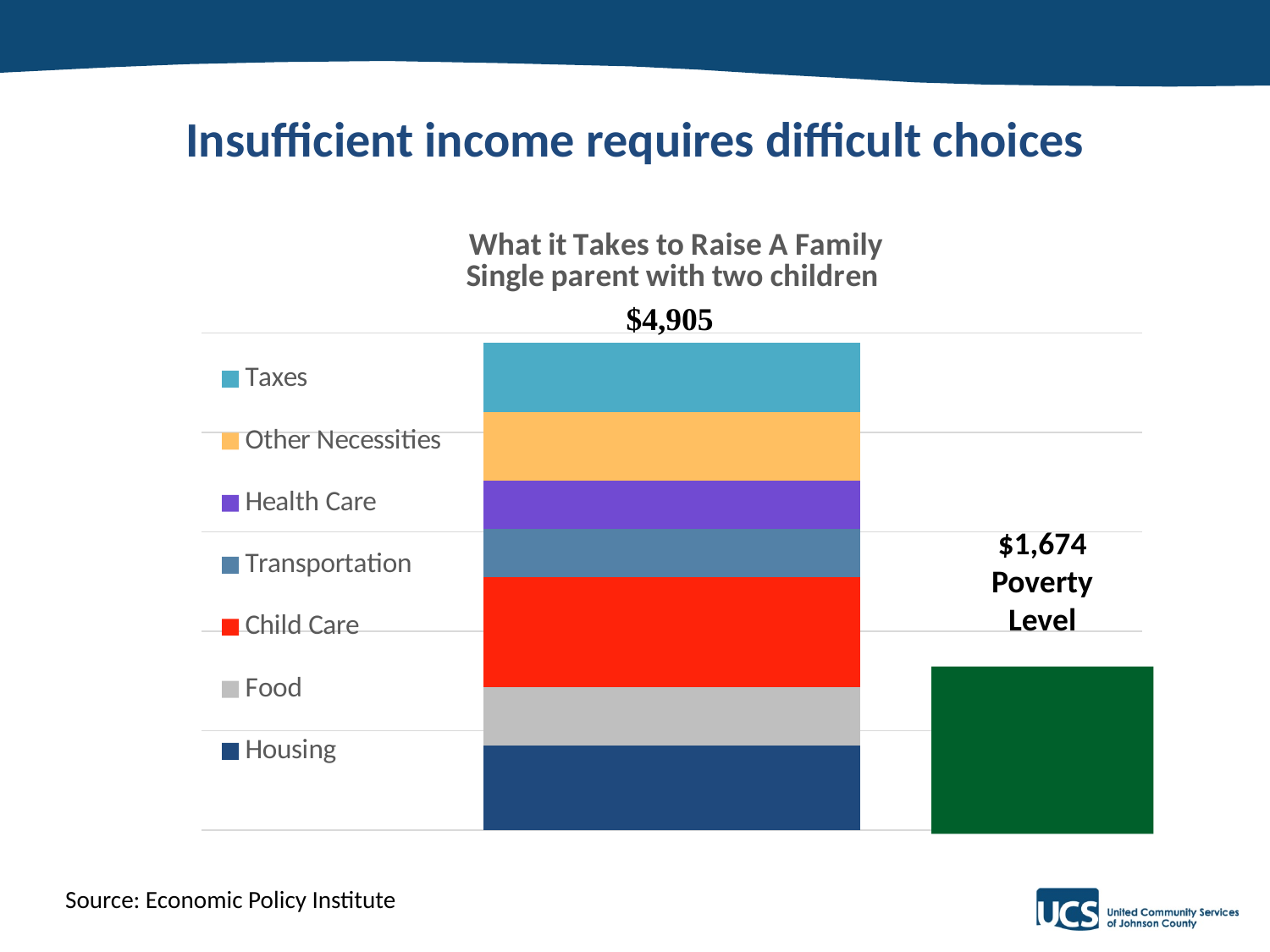
How many categories does the legend list? 7 Which segment is larger in the stacked bar, Child Care or Taxes? Child Care Which is larger, the cost to raise a family or the Poverty Level? The cost to raise a family How many bars are plotted on the chart? 2 What kind of chart is shown on the slide? Stacked bar chart Which expense category takes up the largest segment of the stacked bar? Child Care What is the difference between the cost to raise a family ($4,905) and the Poverty Level ($1,674)? $3,231 What colour represents Child Care in the chart? Red What value is shown for the Poverty Level bar? $1,674 What is the total of the stacked bar for a single parent with two children? $4,905 What is the title of the chart? What it Takes to Raise A Family Single parent with two children Which segment is larger in the stacked bar, Housing or Food? Housing